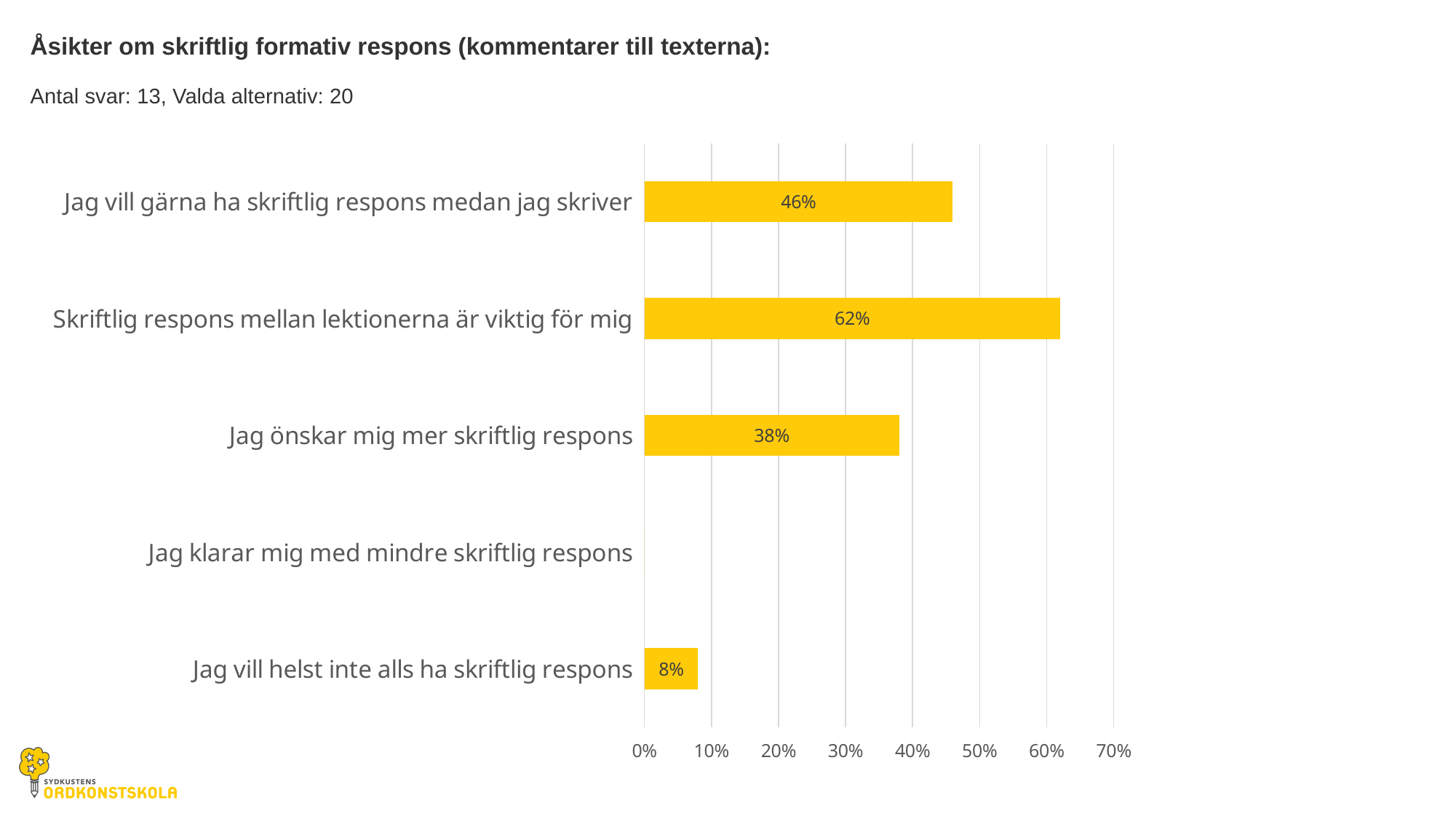
Is the value for "Skriftlig respons mellan lektionerna är viktig för mig" greater or less than 50%? greater What is the difference between the values for "Skriftlig respons mellan lektionerna är viktig för mig" and "Jag önskar mig mer skriftlig respons"? 24% Which is larger: the value for "Jag vill gärna ha skriftlig respons medan jag skriver" or for "Jag önskar mig mer skriftlig respons"? Jag vill gärna ha skriftlig respons medan jag skriver How many categories are listed on the chart? 5 What is the value for "Skriftlig respons mellan lektionerna är viktig för mig"? 62% What is the value for "Jag önskar mig mer skriftlig respons"? 38% What is the value for "Jag vill helst inte alls ha skriftlig respons"? 8% What is the value for "Jag vill gärna ha skriftlig respons medan jag skriver"? 46% Which category with a visible bar has the lowest value? Jag vill helst inte alls ha skriftlig respons Which category has the highest value? Skriftlig respons mellan lektionerna är viktig för mig What kind of chart is shown on the slide? Bar chart What is the title of the chart? Åsikter om skriftlig formativ respons (kommentarer till texterna):